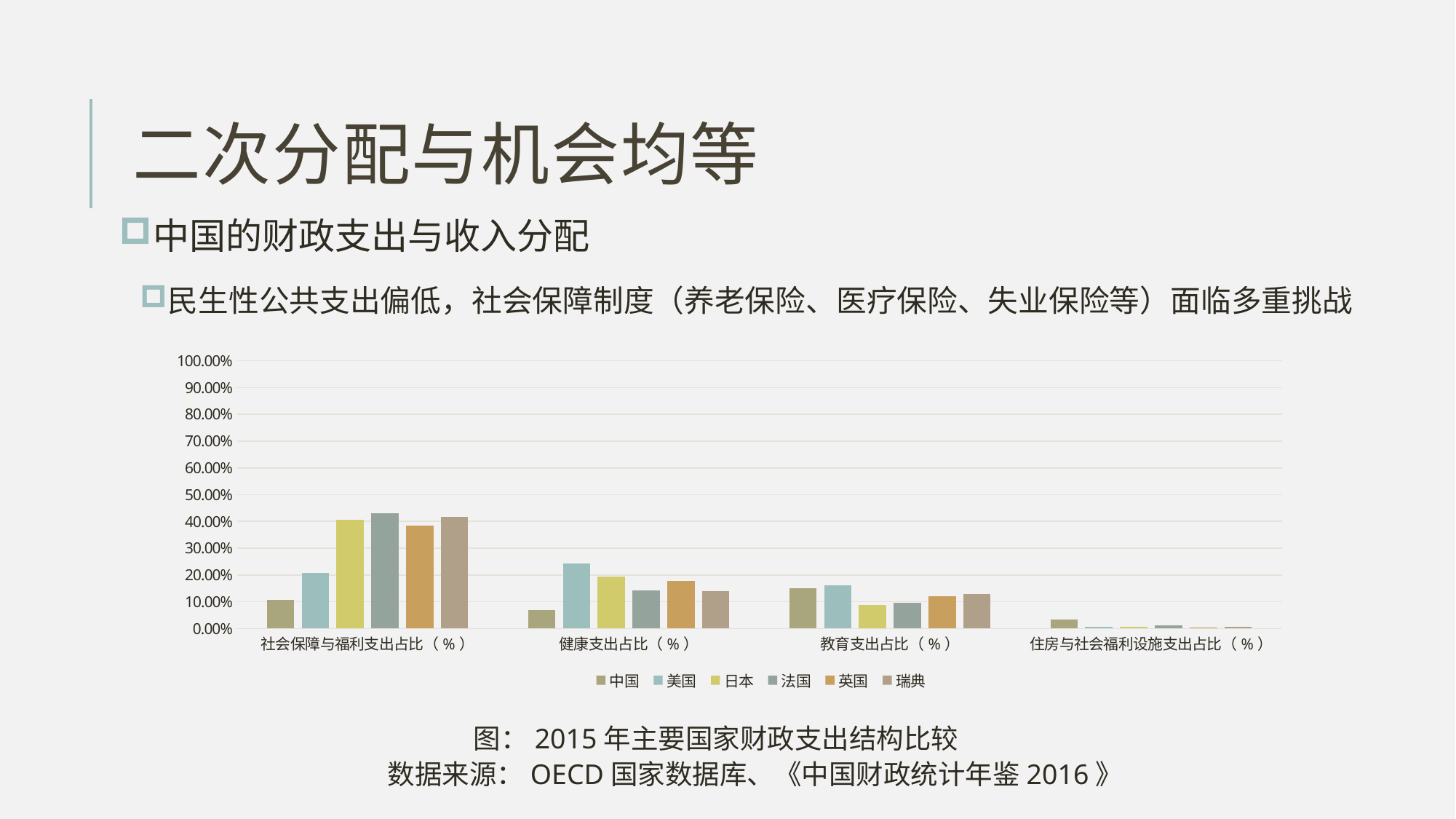
Which country has the lowest value for 社会保障与福利支出占比（%）? 中国 Which country has the highest value for 健康支出占比（%）? 美国 How many series does the chart legend list? 6 Is the value for 法国 in 社会保障与福利支出占比（%） greater or less than 40%? greater How many categories are shown on the x axis of the chart? 4 Which country has the lowest value for 健康支出占比（%）? 中国 What kind of chart is shown on the slide? bar chart Which series is listed first in the chart legend? 中国 For 教育支出占比（%）, which is larger: the value for 中国 or the value for 日本? 中国 Which country has the highest value for 住房与社会福利设施支出占比（%）? 中国 Is the value for 中国 in 社会保障与福利支出占比（%） greater or less than 20%? less Is the value for 美国 in 健康支出占比（%） greater or less than 20%? greater